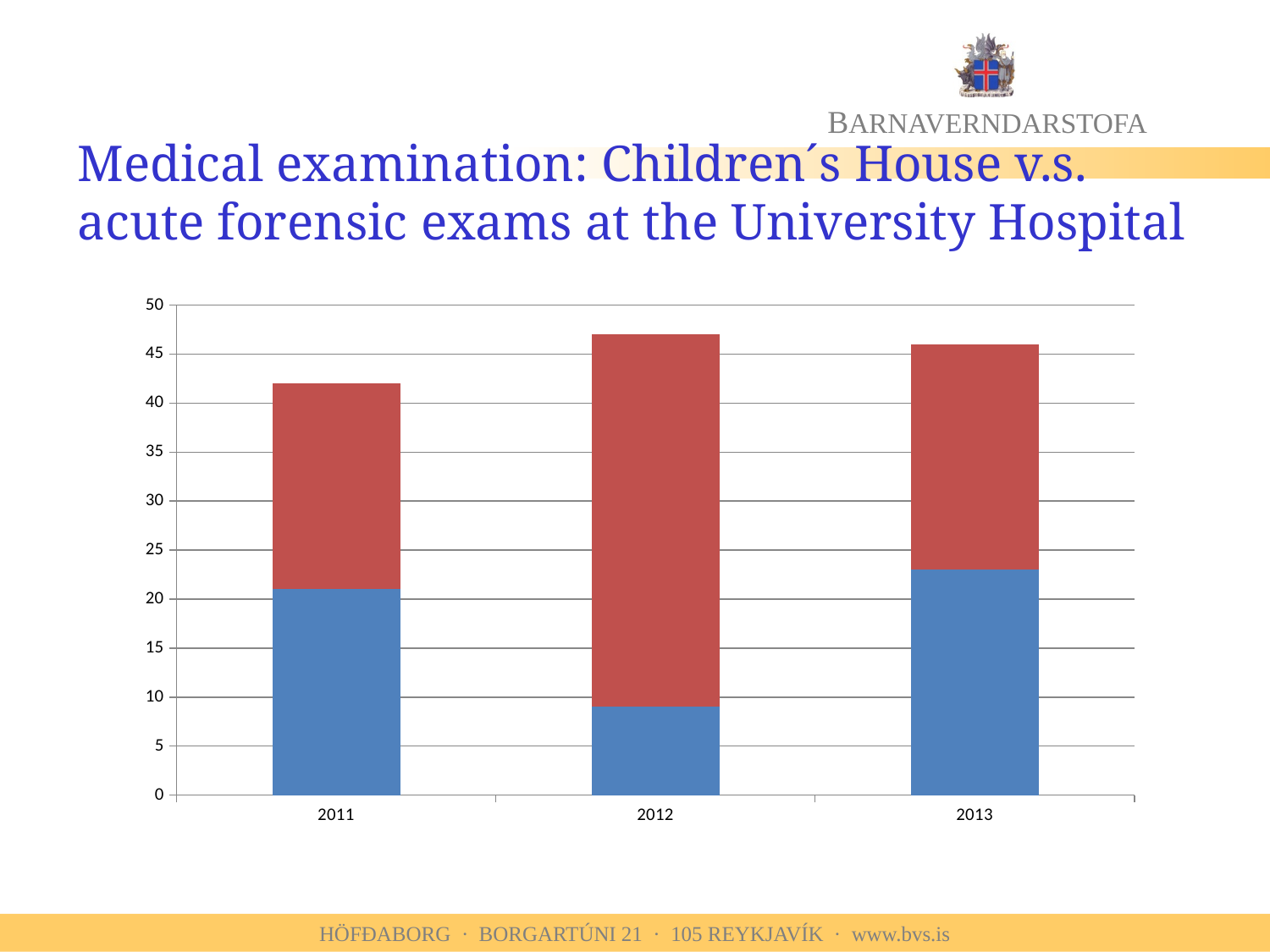
Which year has the largest red segment in the chart? 2012 Is the total bar height for 2012 greater or less than 45? greater Is the blue segment for 2012 greater or less than 10? less How many years are shown on the x axis of the chart? 3 Is the blue segment larger in 2012 or in 2013? 2013 Which years are shown on the x axis of the chart? 2011, 2012, 2013 What kind of chart is shown on the slide? Stacked bar chart Which year has the lowest total bar height in the chart? 2011 Is the blue segment for 2013 greater or less than 20? greater What is the title of the slide containing the chart? Medical examination: Children´s House v.s. acute forensic exams at the University Hospital Which year has the smallest blue segment in the chart? 2012